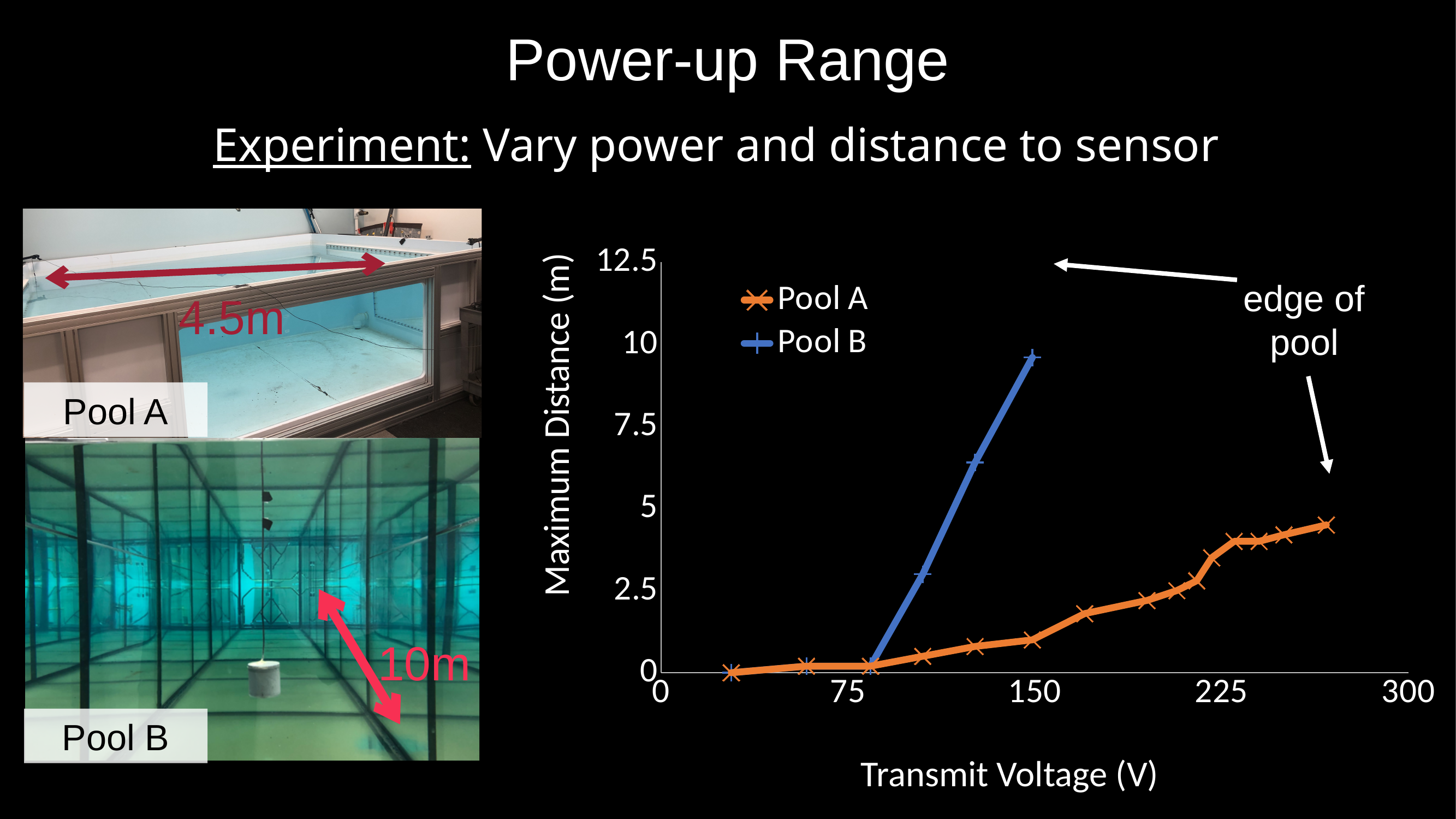
What kind of chart is shown on the slide? line chart Is the maximum distance for Pool A at 150 V greater or less than 2.5? less What is the label of the chart's y axis? Maximum Distance (m) How many series does the chart legend list? 2 At 150 V, which series has the larger maximum distance, Pool A or Pool B? Pool B Is the maximum distance for Pool A at 225 V greater or less than 5? less What are the two series named in the chart legend? Pool A and Pool B Is the maximum distance for Pool A at 225 V greater or less than 2.5? greater Which series reaches the highest maximum distance on the chart? Pool B Does the maximum distance for Pool B rise or fall as transmit voltage increases? rise Does the maximum distance for Pool A rise or fall as transmit voltage increases? rise